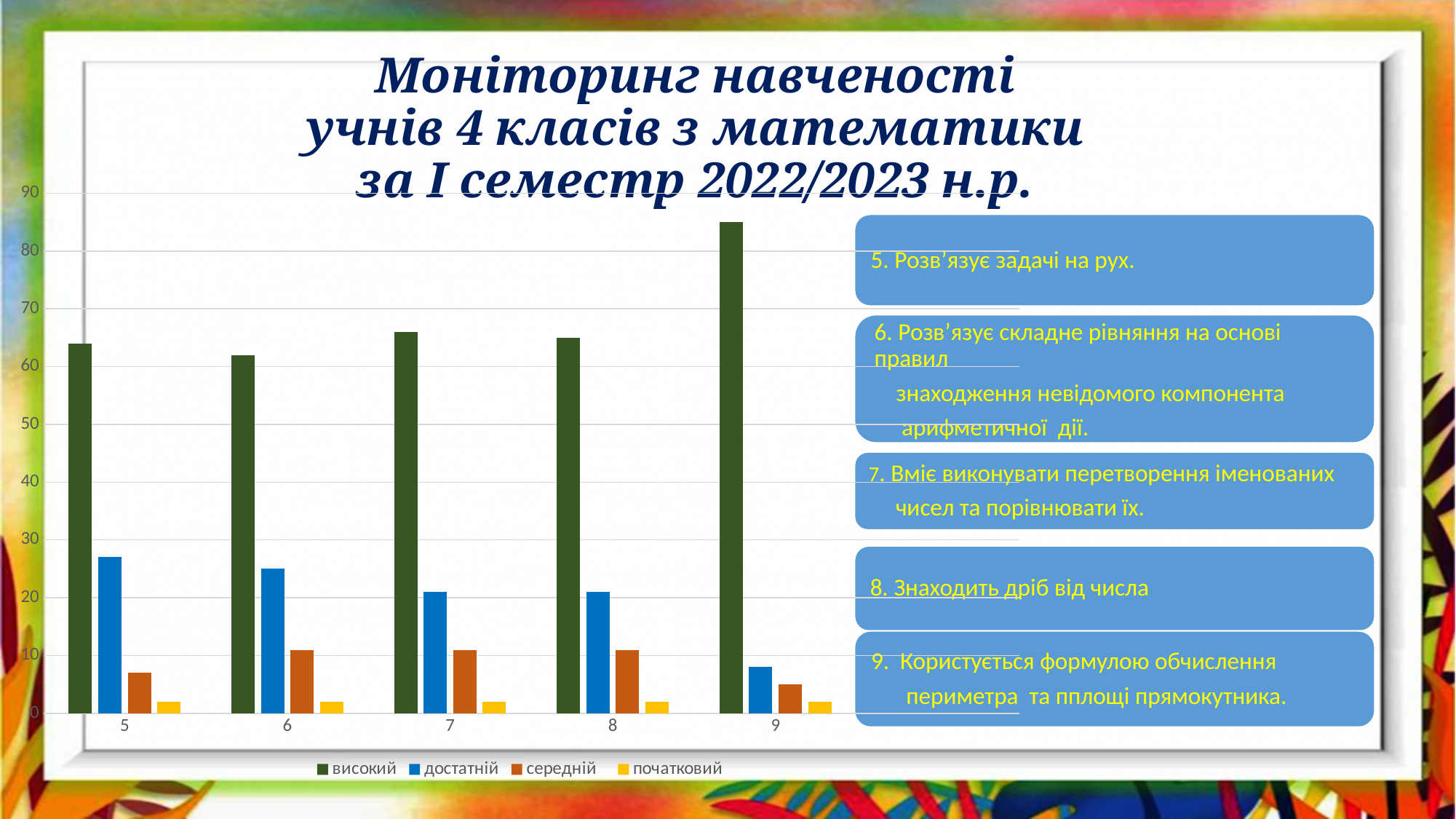
For which category is the 'високий' bar the highest? 9 Which series is shown in dark green in the legend? високий Is the 'високий' value for category 9 greater or less than 80? greater What kind of chart is shown on the slide? bar chart Is the 'середній' value for category 5 greater or less than 10? less How many series does the legend list? 4 Does the 'достатній' series rise or fall from category 5 to category 9? fall Is the 'високий' value for category 5 greater or less than 60? greater For which category is the 'достатній' bar the lowest? 9 Which is larger for category 7: the 'високий' bar or the 'достатній' bar? високий How many categories are shown on the x axis? 5